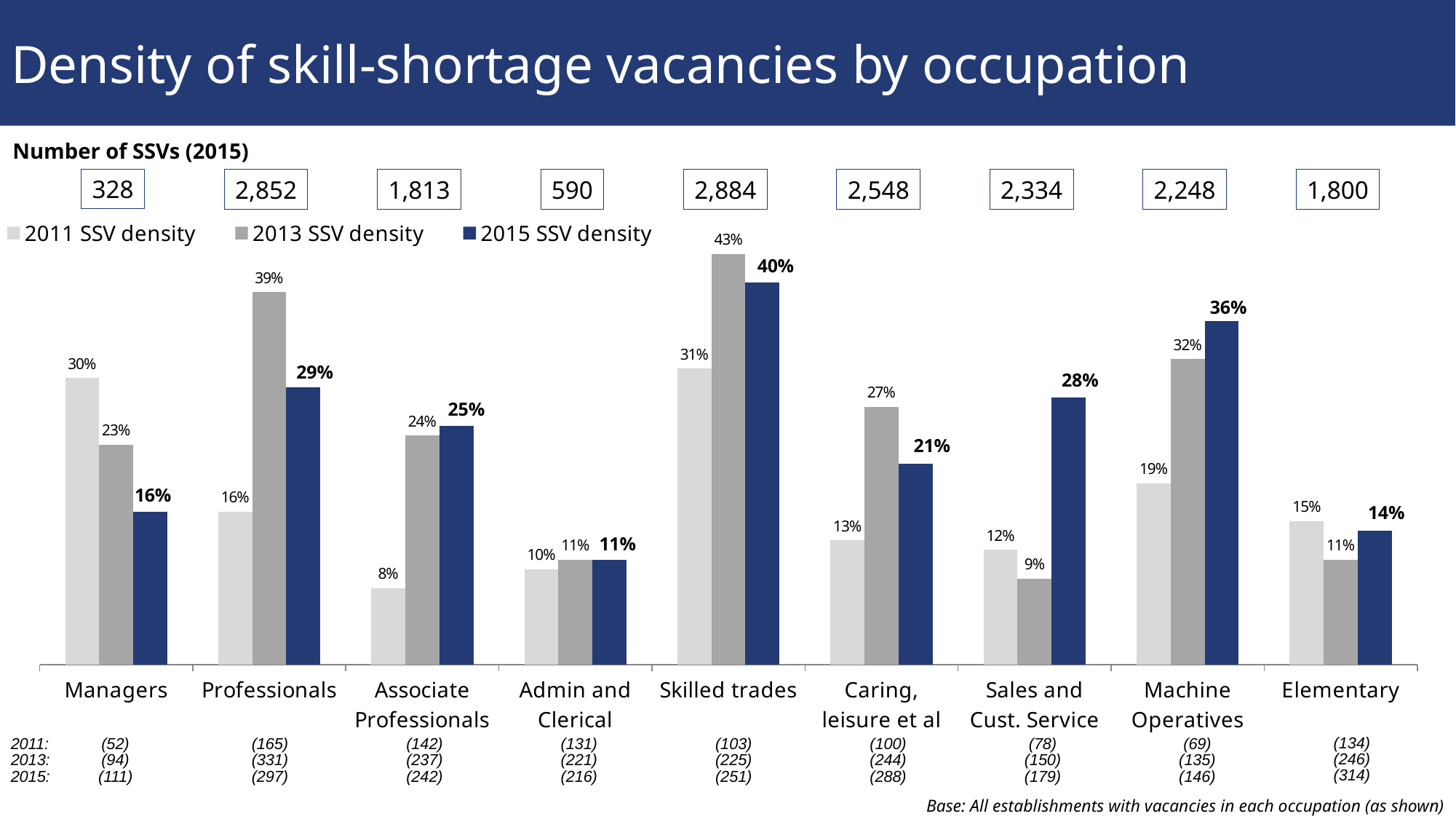
Which is larger for Sales and Cust. Service: the 2013 SSV density or the 2015 SSV density? 2015 SSV density How many series does the legend list? 3 Which occupation has the lowest 2015 SSV density? Admin and Clerical What is the title of the slide? Density of skill-shortage vacancies by occupation What is the 2013 SSV density for Professionals? 39% What is the 2015 SSV density for Skilled trades? 40% What is the difference between the 2015 and 2011 SSV density for Machine Operatives? 17% Which occupation has the highest 2015 SSV density? Skilled trades How many occupation categories are shown on the x axis? 9 What kind of chart is shown on the slide? Bar chart What is the 2011 SSV density for Managers? 30% What is the number of SSVs (2015) shown above the Skilled trades category? 2,884